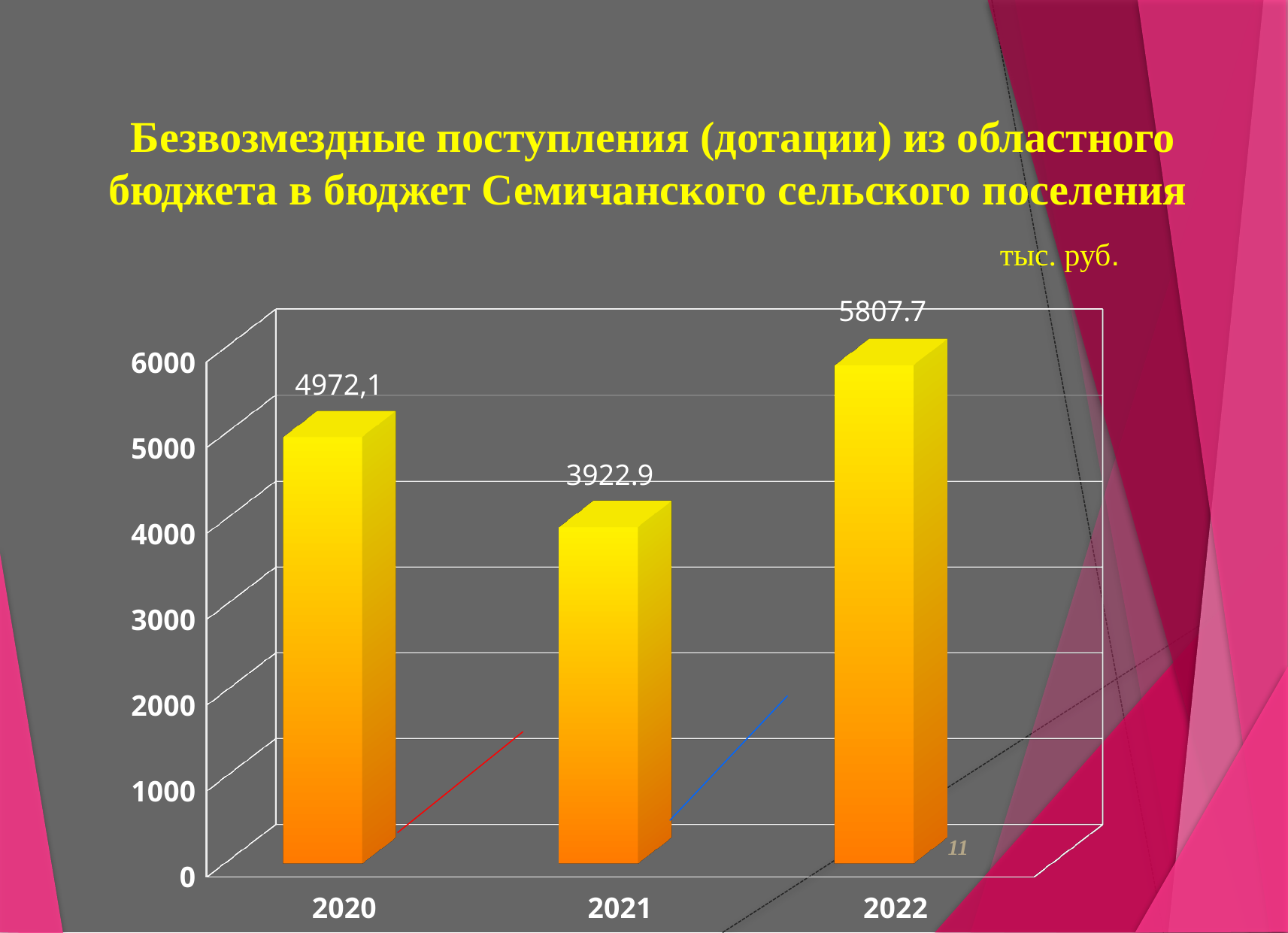
What is the difference between the values for 2020 and 2021? 1049.2 Did the value rise or fall from 2021 to 2022? rise What is the value for 2021? 3922.9 Which year has the lowest value? 2021 What is the value for 2020? 4972,1 Is the value for 2021 greater or less than 4000? less How many years are shown on the x axis? 3 What kind of chart is shown on the slide? bar chart What is the difference between the values for 2022 and 2021? 1884.8 Which is larger, the value for 2020 or the value for 2022? 2022 What is the value for 2022? 5807.7 Which year has the highest value? 2022